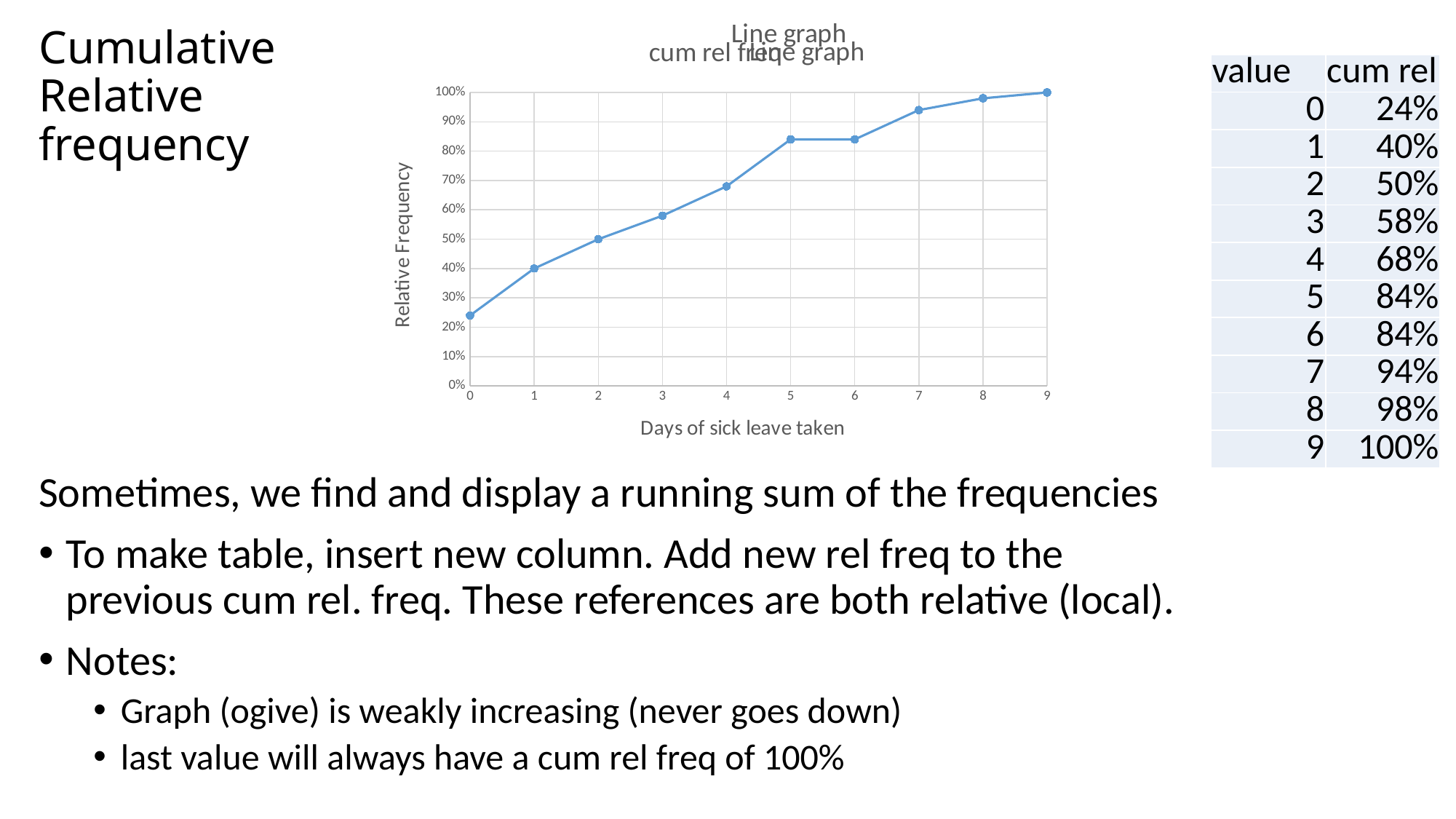
What is the relative frequency value plotted at 9 days of sick leave taken? 100% What is the relative frequency value plotted at 1 day of sick leave taken? 40% Which is larger: the value plotted at 4 days or the value plotted at 7 days? 7 days What is the title of the x axis of the chart? Days of sick leave taken Which number of days of sick leave has the highest plotted value? 9 Is the value plotted at 0 days of sick leave greater or less than 30%? less Is the value plotted at 5 days of sick leave greater or less than 80%? greater Do the plotted values rise or fall as the number of days of sick leave increases? rise Which number of days of sick leave has the lowest plotted value? 0 What is the relative frequency value plotted at 2 days of sick leave taken? 50% How many data points are plotted on the line chart? 10 What kind of chart is shown on the slide? line chart